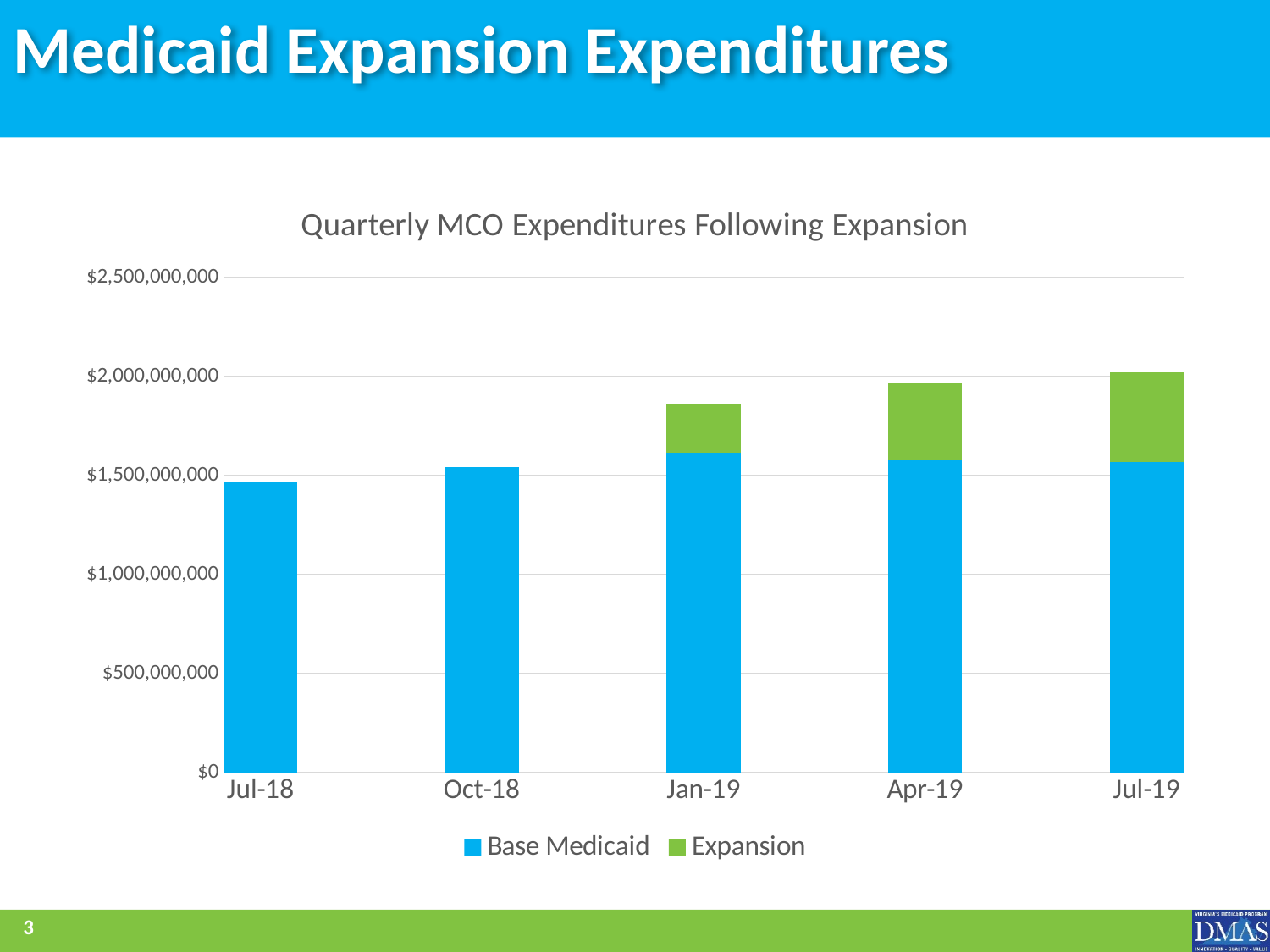
Which quarter has the largest Expansion segment? Jul-19 How many quarters (categories) are shown on the x axis? 5 Is the total expenditure for Apr-19 greater or less than $2,000,000,000? less Is the Base Medicaid value for Jul-18 greater or less than $1,500,000,000? less Do total quarterly expenditures rise or fall from Jul-18 to Jul-19? rise Which quarter has the lowest total expenditure? Jul-18 Which series is shown in green? Expansion What is the title of the chart? Quarterly MCO Expenditures Following Expansion How many series does the legend list? 2 What type of chart is shown on the slide? Stacked bar chart Which quarter has the highest total expenditure? Jul-19